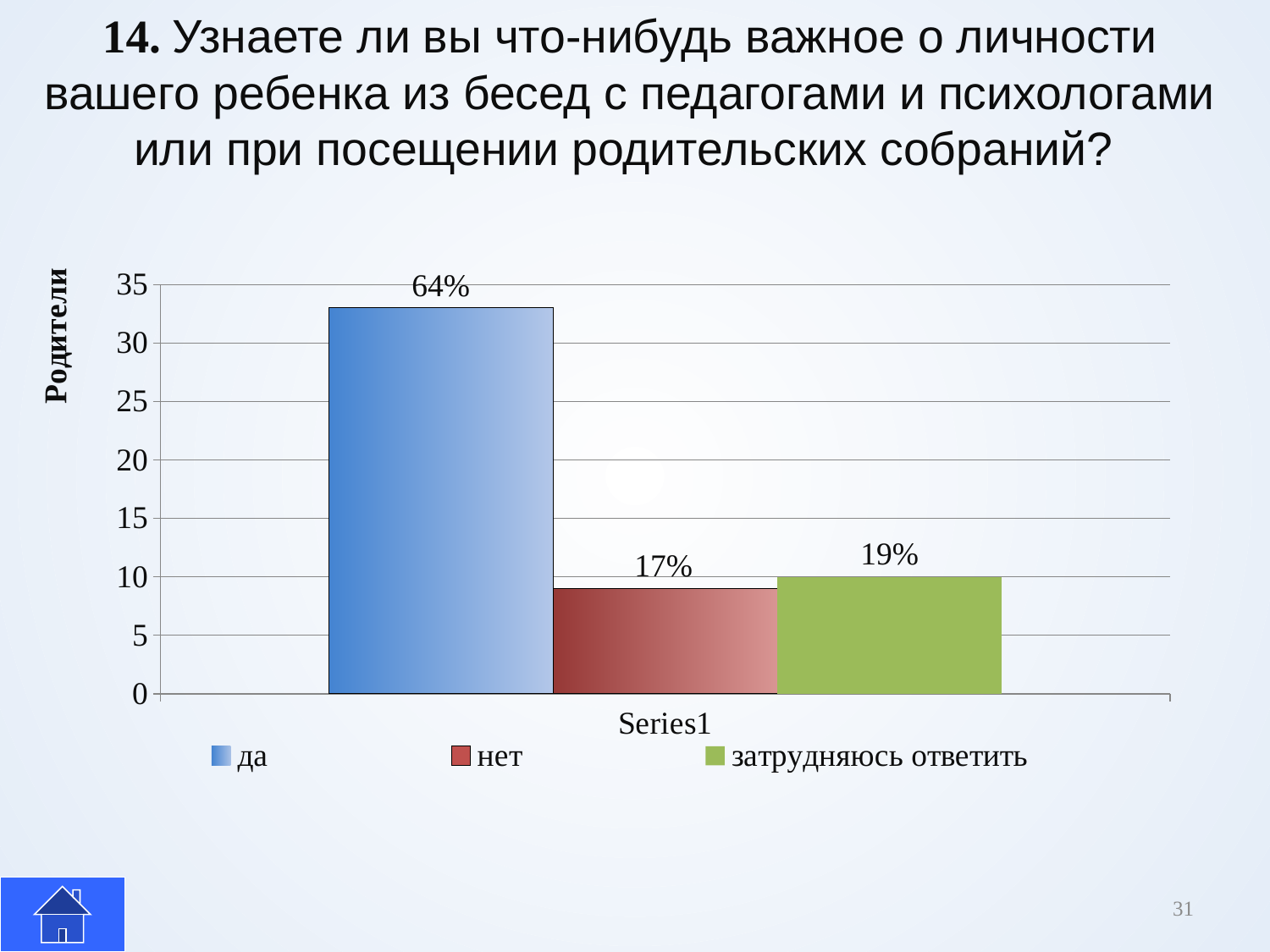
What is the data label on the bar for "да"? 64% What is the title of the vertical axis? Родители Which is larger, the value for "нет" or the value for "затрудняюсь ответить"? затрудняюсь ответить By how many percentage points does the label for "да" exceed the label for "нет"? 47 How many bars are plotted in the chart? 3 What kind of chart is shown on the slide? bar chart Is the bar for "нет" greater or less than 10 on the vertical axis? less Is the bar for "да" greater or less than 30 on the vertical axis? greater Which answer option has the tallest bar? да What is the data label on the bar for "затрудняюсь ответить"? 19% What is the data label on the bar for "нет"? 17% Which answer option has the shortest bar? нет